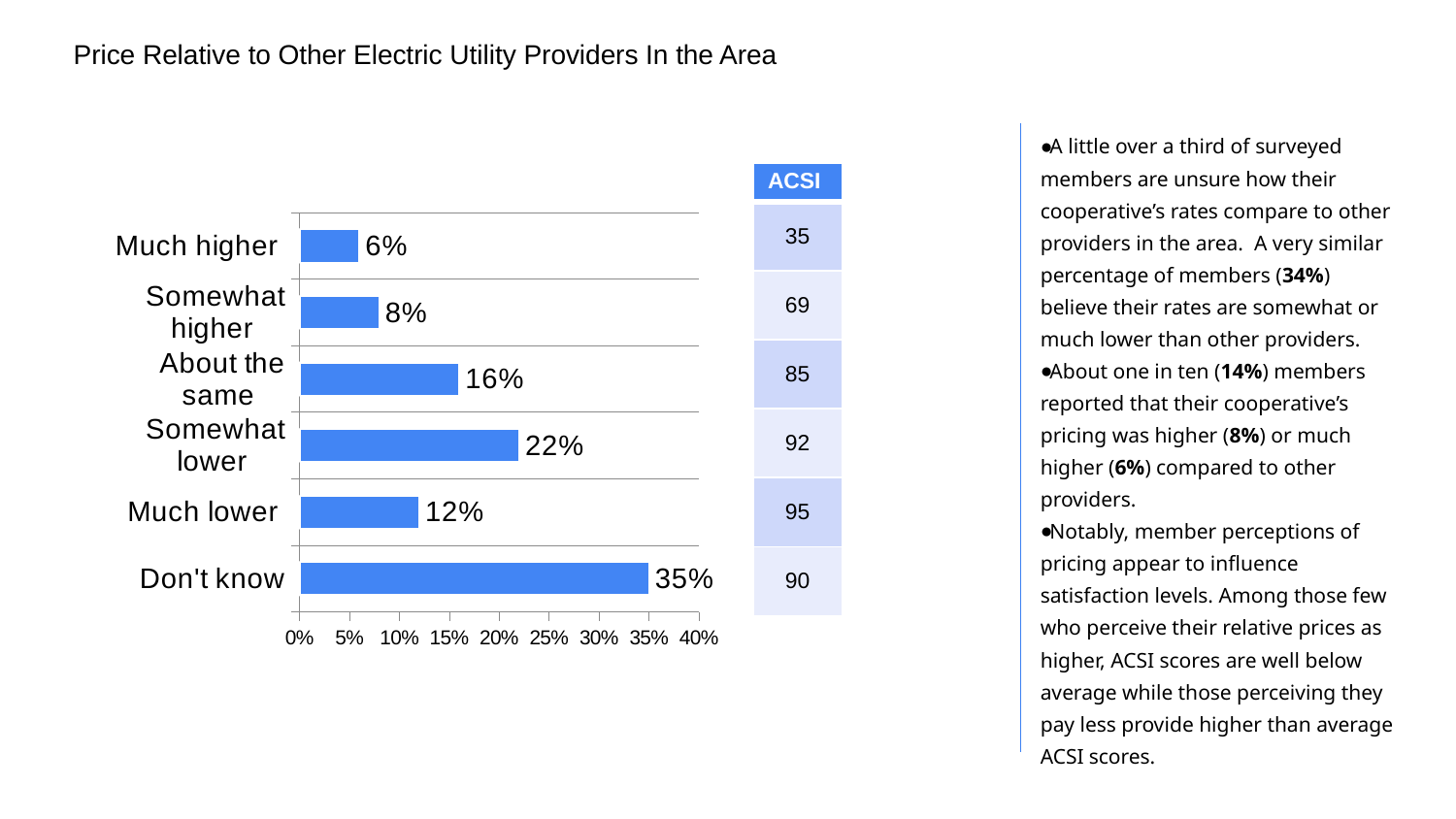
Which category has the lowest percentage in the bar chart? Much higher What is the difference in percentage points between "Somewhat lower" and "Much lower"? 10% What percentage of members answered "Don't know"? 35% Which is larger, the percentage for "About the same" or for "Much lower"? About the same How many categories are shown in the bar chart? 6 What is the title of the chart? Price Relative to Other Electric Utility Providers In the Area What kind of chart is shown on the slide? Bar chart Is the value for "Don't know" greater or less than 30%? greater What percentage of members answered "Somewhat lower"? 22% Which category has the highest percentage in the bar chart? Don't know What is the ACSI score listed next to the "Much higher" category? 35 What percentage of members said their cooperative's price is "Much higher" than other providers? 6%